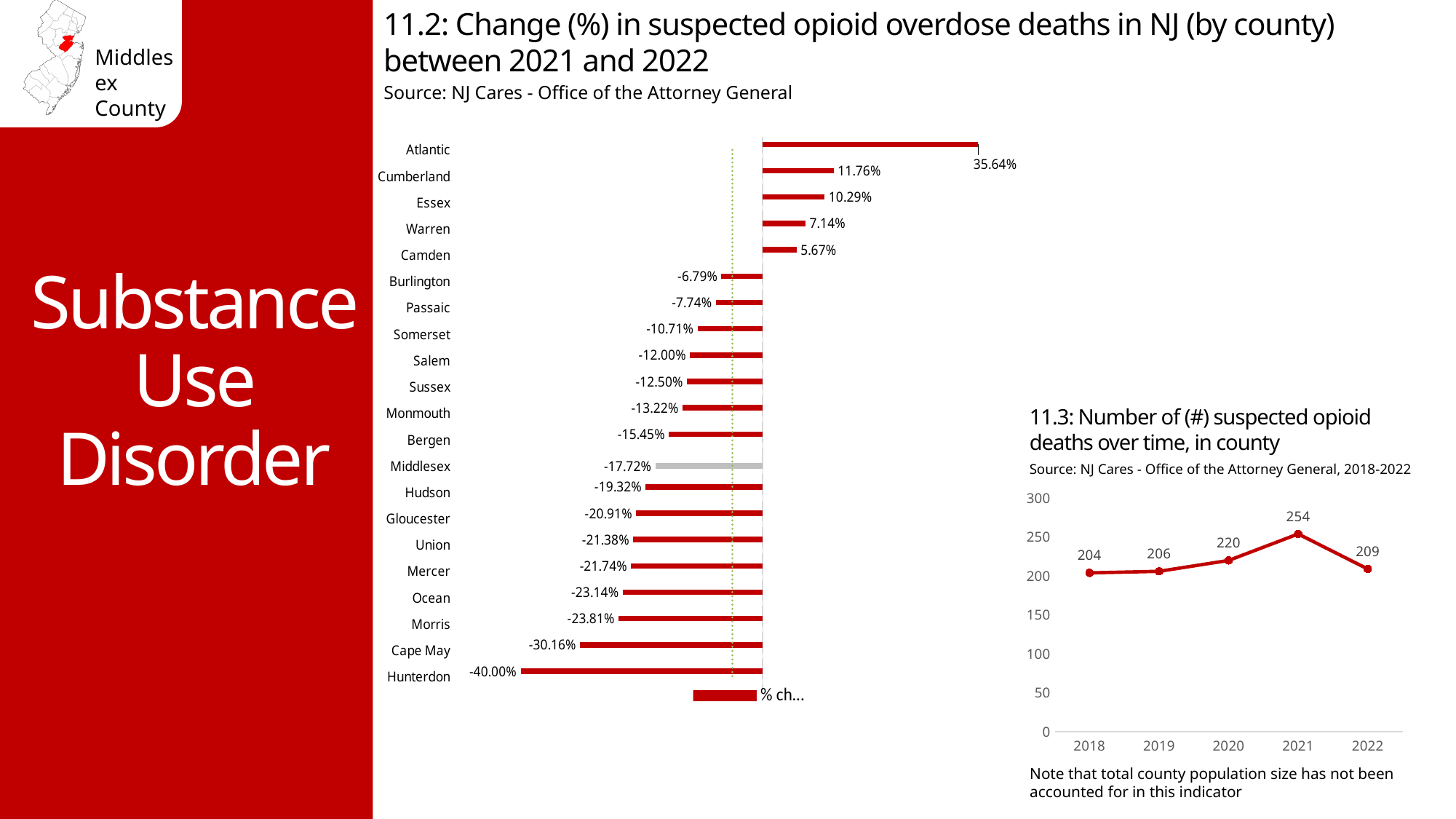
In chart 11.3, what is the difference between the values for 2021 and 2022? 45 What kind of chart is chart 11.3? Line chart In chart 11.2, which county has the lowest percentage change? Hunterdon In chart 11.2, what is the difference between the values for Atlantic and Cumberland? 23.88 percentage points In chart 11.2, which has a larger percentage change, Essex or Warren? Essex In chart 11.3 (number of suspected opioid deaths over time), what is the value for 2021? 254 What kind of chart is chart 11.2? Bar chart In chart 11.2, how many counties are shown? 21 In chart 11.2 (change in suspected opioid overdose deaths by county), what is the value for Middlesex? -17.72% In chart 11.3, which year has the lowest number of suspected opioid deaths? 2018 In chart 11.2, which county has the highest percentage change? Atlantic In chart 11.2, what is the value for Cumberland? 11.76%